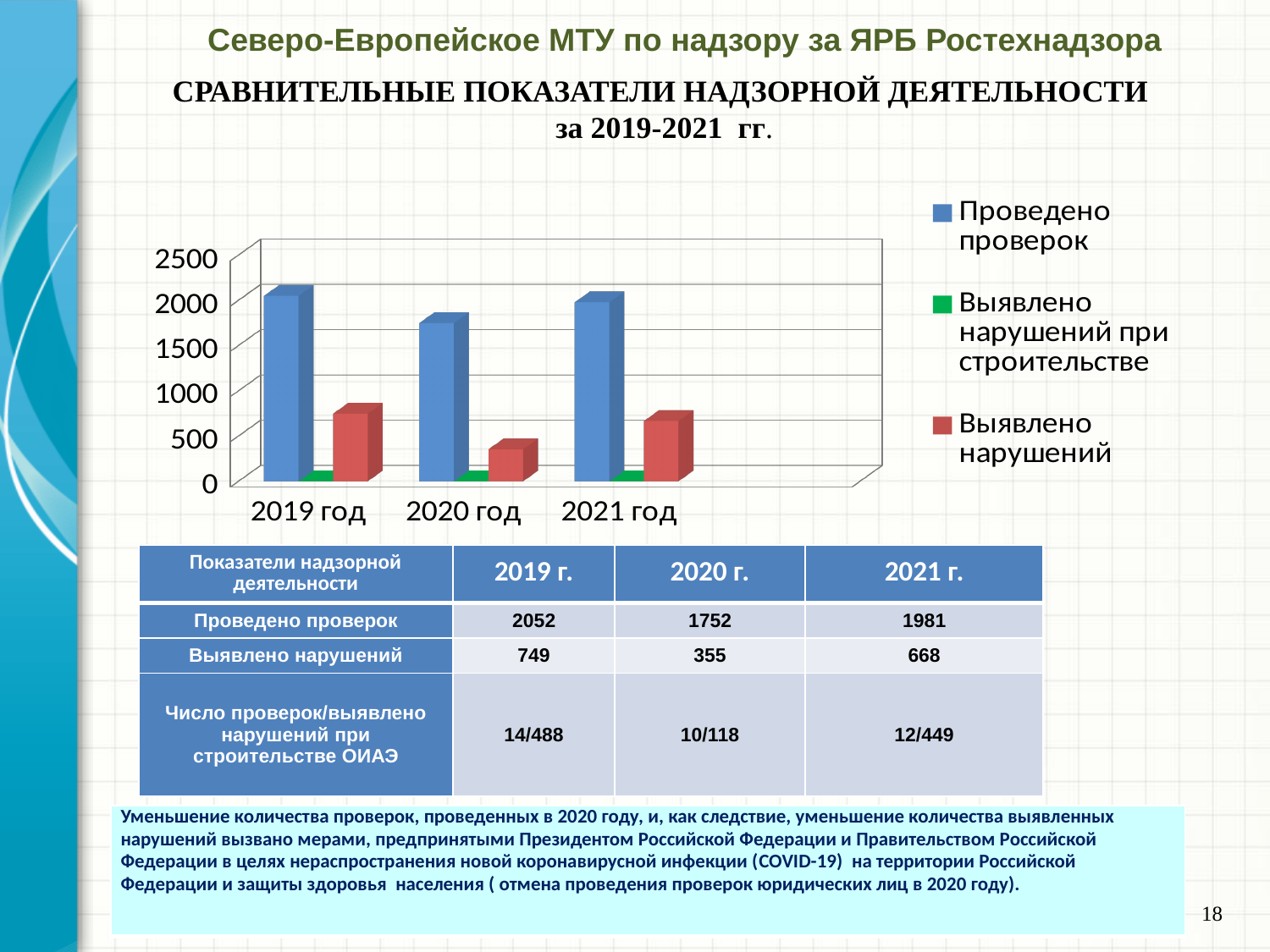
What is the value of Проведено проверок for 2019 год? 2052 How many series does the chart legend list? 3 What is the difference between Проведено проверок in 2019 год and 2020 год? 300 Which year has the larger value of Выявлено нарушений, 2019 год or 2021 год? 2019 год Is the value of Проведено проверок for 2020 год greater or less than 1500? greater What is the value of Выявлено нарушений for 2020 год? 355 What kind of chart is shown on the slide? bar chart What colour represents the series Проведено проверок in the chart? blue In which year is Выявлено нарушений the lowest? 2020 год Does Проведено проверок rise or fall from 2019 год to 2020 год? fall How many year categories are shown on the x axis of the chart? 3 In which year is Проведено проверок the highest? 2019 год